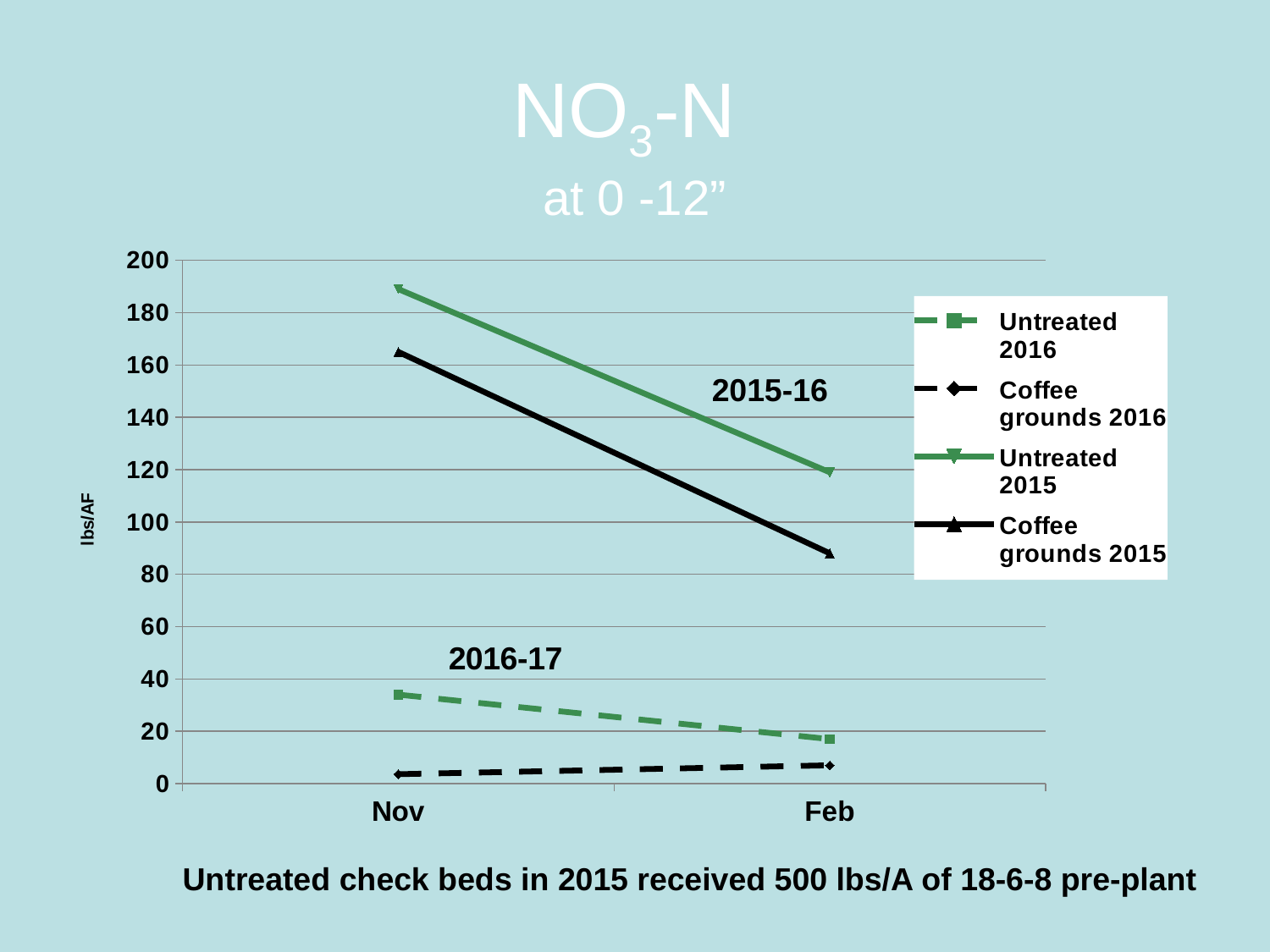
Is the value for Coffee grounds 2015 at Feb greater or less than 100? less Which series has the highest value at Nov? Untreated 2015 What is the label on the y axis? lbs/AF At Feb, which is larger: Untreated 2015 or Coffee grounds 2015? Untreated 2015 Is the value for Coffee grounds 2015 at Nov greater or less than 140? greater Is the value for Untreated 2016 at Nov greater or less than 40? less Which series has the lowest value at Nov? Coffee grounds 2016 How many points are there along the x axis? 2 Do the values for Untreated 2015 rise or fall from Nov to Feb? fall How many series does the legend list? 4 What kind of chart is shown on the slide? line chart